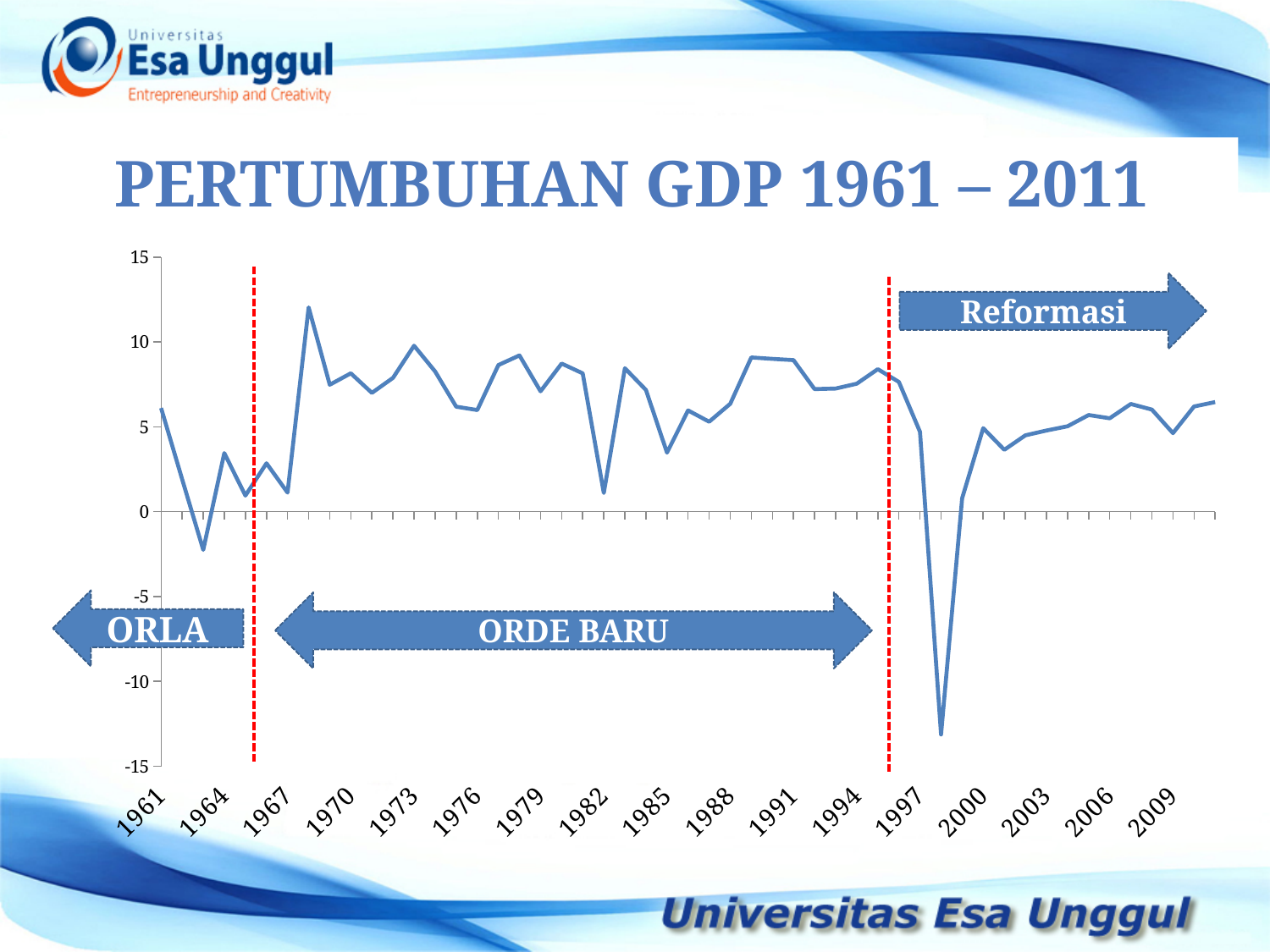
Is the GDP growth value for 1985 greater or less than 5? less Is the GDP growth value for 1968 greater or less than 10? greater What is the title of the chart? PERTUMBUHAN GDP 1961 – 2011 Which year has the lowest GDP growth value on the chart? 1998 Which year has the larger GDP growth value, 1963 or 1964? 1964 Which year has the highest GDP growth value on the chart? 1968 What are the three period labels annotated on the chart? ORLA, ORDE BARU, Reformasi How many year labels are shown on the x axis? 17 Is the GDP growth value for 1963 greater or less than 0? less Does the GDP growth value rise or fall from 1998 to 2000? rise What kind of chart is shown on the slide? line chart